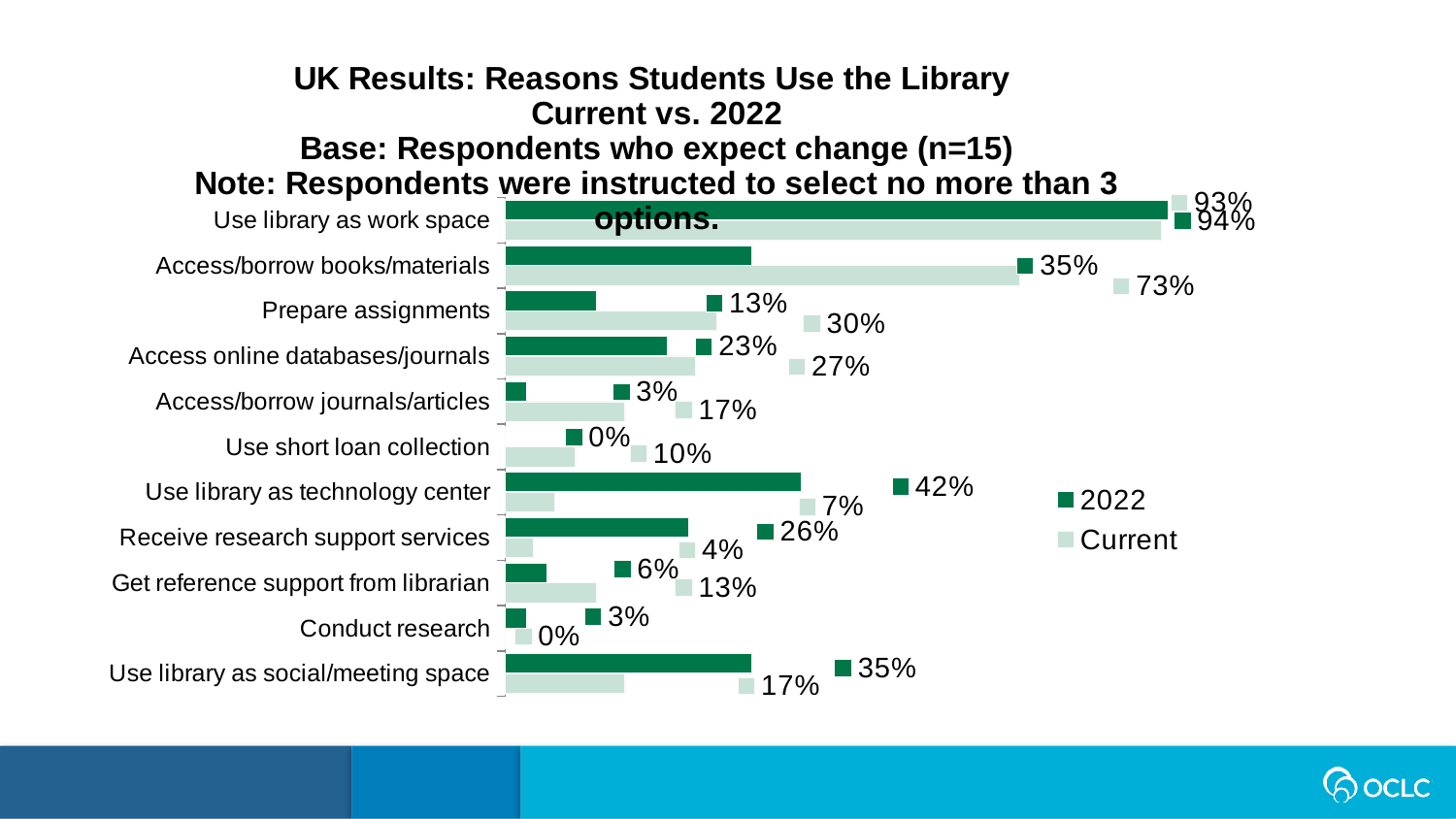
What kind of chart is shown on the slide? Bar chart What is the Current value for Use short loan collection? 10% What is the Current value for Access/borrow books/materials? 73% Which series is shown in dark green? 2022 What is the 2022 value for Prepare assignments? 13% What is the difference between the Current and 2022 values for Access/borrow books/materials? 38% How many categories are shown on the chart? 11 Which is larger for Use library as social/meeting space, the 2022 value or the Current value? 2022 How many series does the legend list? 2 Which category has the lowest 2022 value? Use short loan collection What is the 2022 value for Use library as technology center? 42% Which category has the highest Current value? Use library as work space